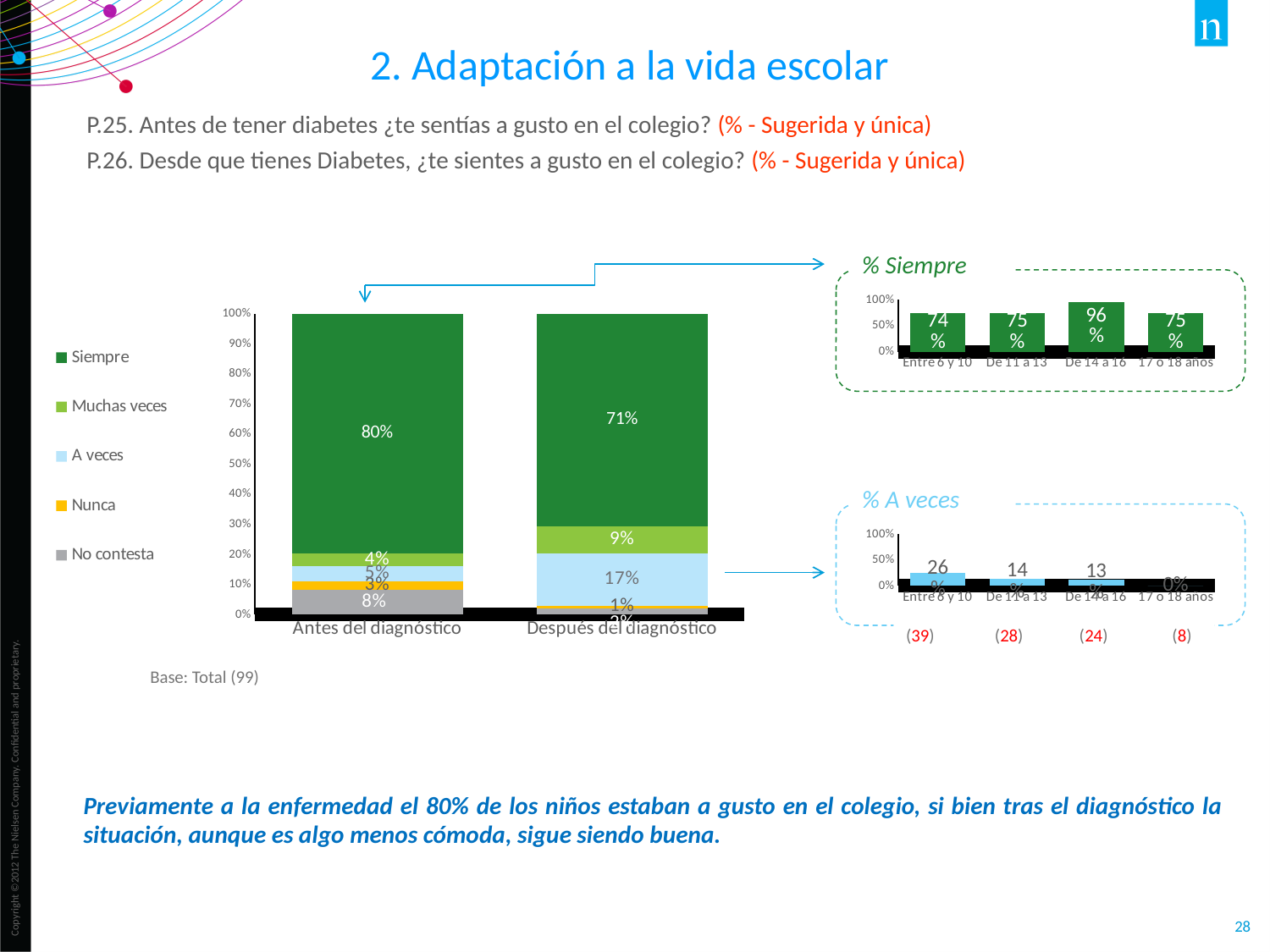
How many series does the legend of the main stacked bar chart list? 5 In the main stacked bar chart, what is the 'Muchas veces' value for 'Después del diagnóstico'? 9% In the '% Siempre' chart, which age group has the highest value? De 14 a 16 In the main stacked bar chart, by how many percentage points does 'Siempre' drop from 'Antes del diagnóstico' to 'Después del diagnóstico'? 9 percentage points In the main stacked bar chart, what percentage answered 'Siempre' for 'Antes del diagnóstico'? 80% In the main stacked bar chart, what is the 'A veces' value for 'Después del diagnóstico'? 17% In the '% A veces' chart, what is the value for 'Entre 6 y 10'? 26% What kind of chart is the main chart on the left of the slide? Stacked bar chart In the main stacked bar chart, what percentage answered 'Siempre' for 'Después del diagnóstico'? 71% In the '% A veces' chart, which age group has the lowest value? 17 o 18 años In the '% Siempre' chart, what is the value for 'Entre 6 y 10'? 74% In the main stacked bar chart, which bar has the larger 'A veces' share, 'Antes del diagnóstico' or 'Después del diagnóstico'? Después del diagnóstico